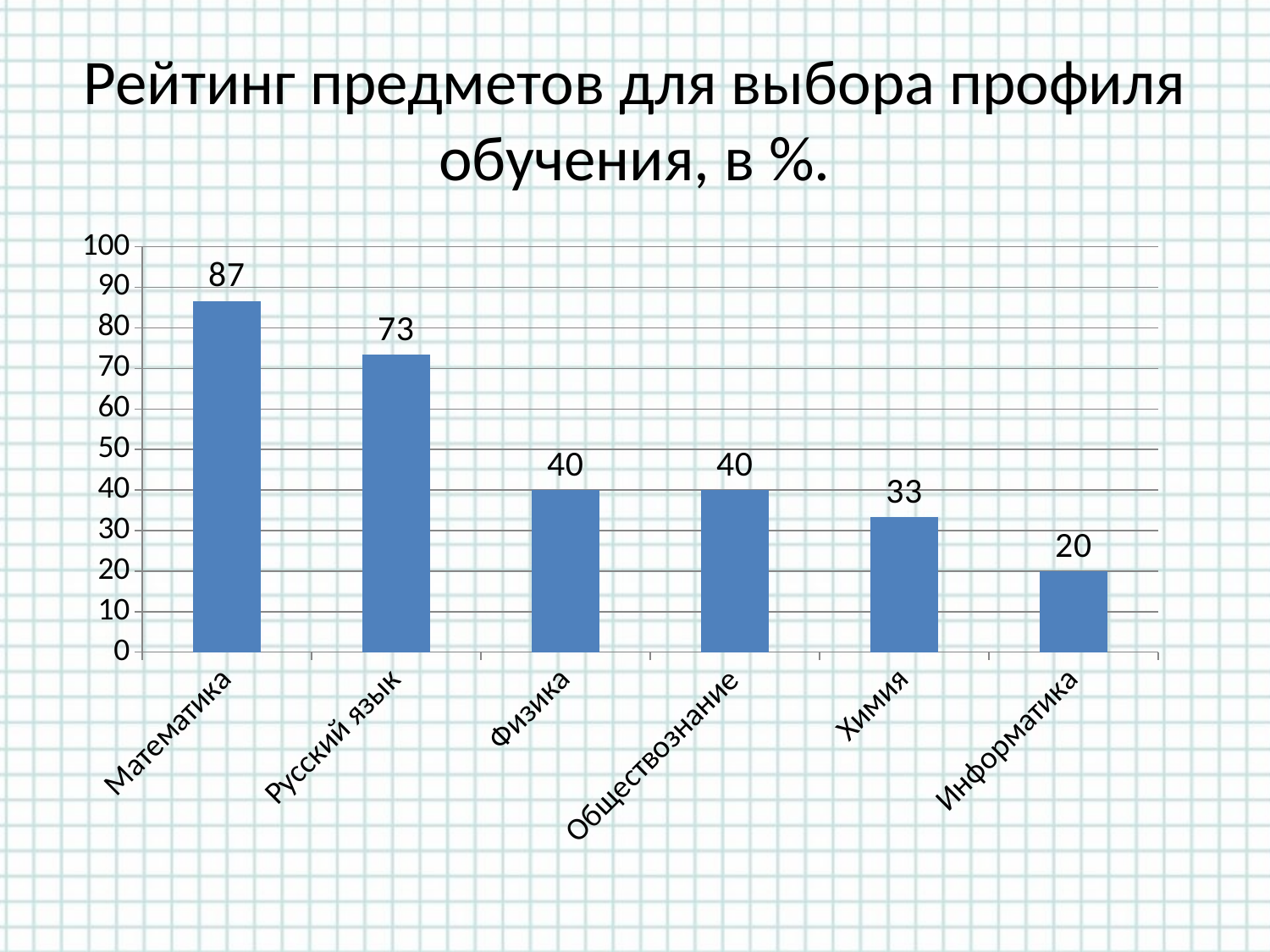
What is the value for Информатика? 20 What is the value for Русский язык? 73 Is the value for Обществознание greater or less than 50? less What is the title of the chart? Рейтинг предметов для выбора профиля обучения, в %. What kind of chart is shown on the slide? bar chart What is the value for Химия? 33 Which subject has the highest value? Математика Which is larger, the value for Химия or the value for Физика? Физика What is the difference between the values for Математика and Русский язык? 14 What is the value for Математика? 87 How many subjects are shown on the chart? 6 Which subject has the lowest value? Информатика